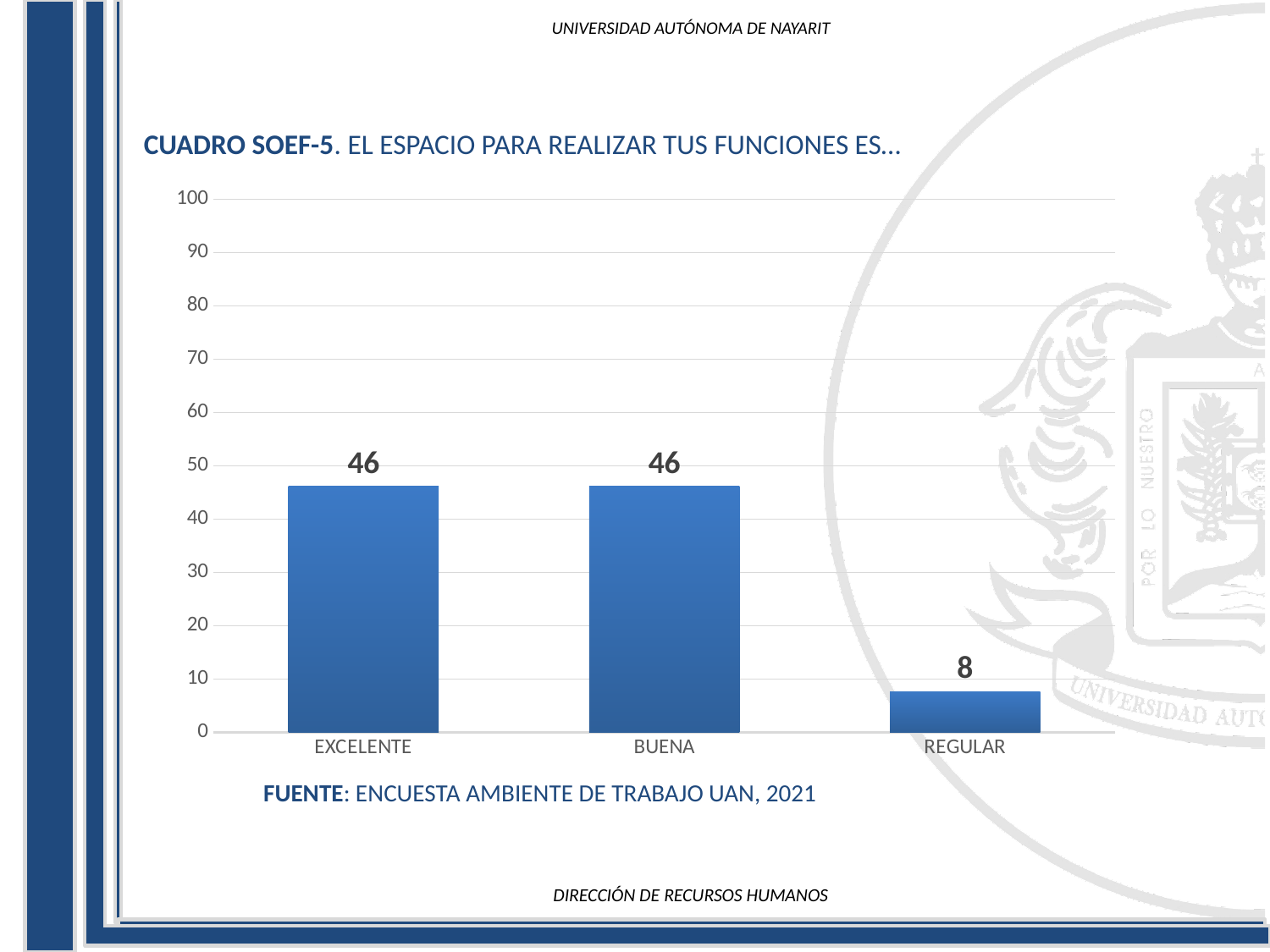
What is the difference between the values for BUENA and REGULAR? 38 What kind of chart is shown on the slide? bar chart Which category has the lowest value? REGULAR What is the value for REGULAR? 8 What is the value for EXCELENTE? 46 Which is larger, the value for EXCELENTE or the value for REGULAR? EXCELENTE Is the value for REGULAR greater or less than 10? less What source is cited below the chart? ENCUESTA AMBIENTE DE TRABAJO UAN, 2021 What is the value for BUENA? 46 Is the value for BUENA greater or less than 40? greater How many categories are shown on the x axis? 3 What is the highest value shown on the y axis? 100